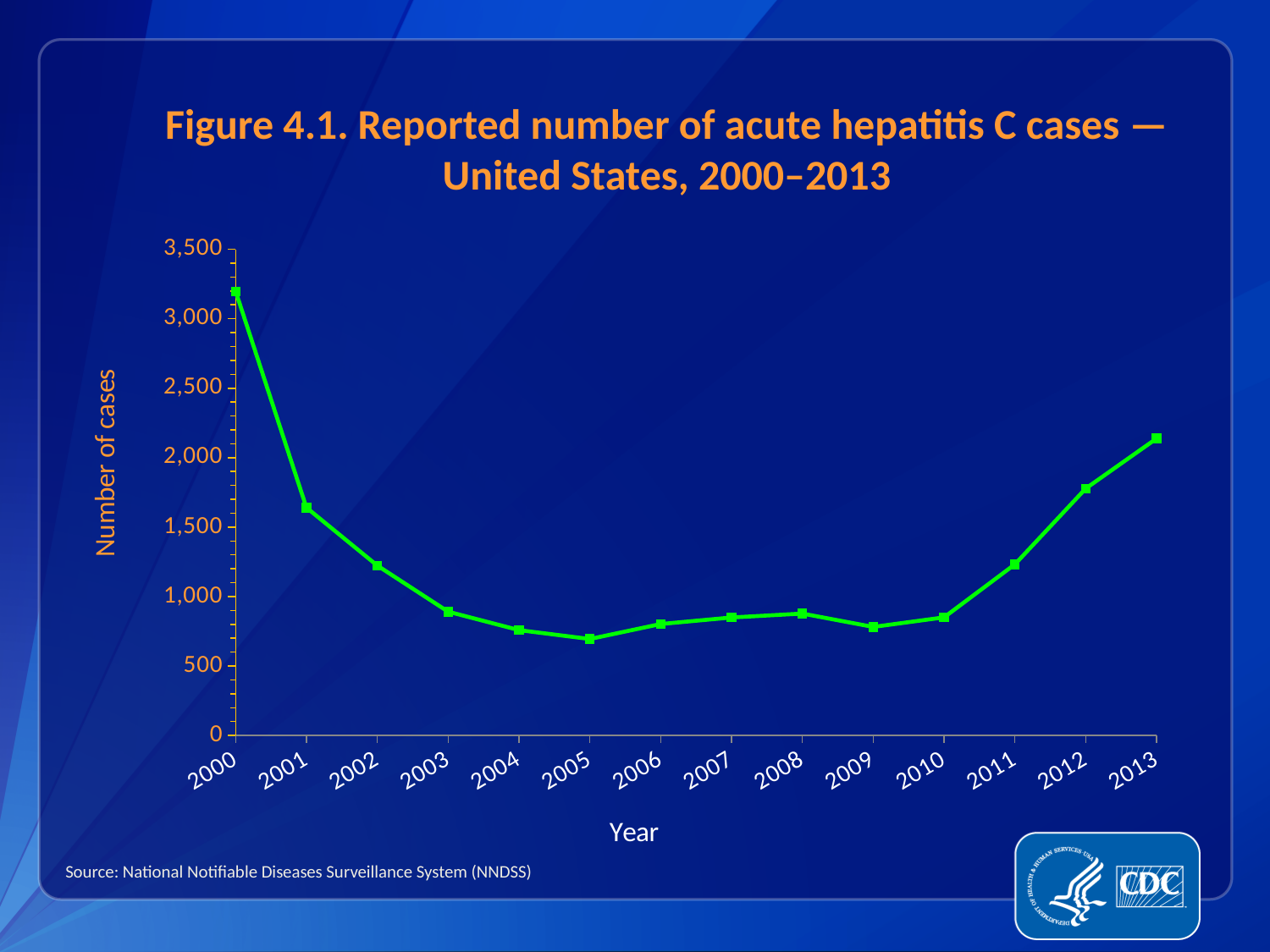
What is the title of the vertical axis? Number of cases Is the value for 2003 greater or less than 1,000? less How many years are plotted on the x axis? 14 Do the reported cases rise or fall from 2000 to 2005? fall Is the value for 2000 greater or less than 3,000? greater Is the value for 2012 greater or less than 2,000? less What kind of chart is shown on the slide? line chart Which year has the lowest reported number of acute hepatitis C cases? 2005 Which year has more reported cases, 2000 or 2013? 2000 Which year has the highest reported number of acute hepatitis C cases? 2000